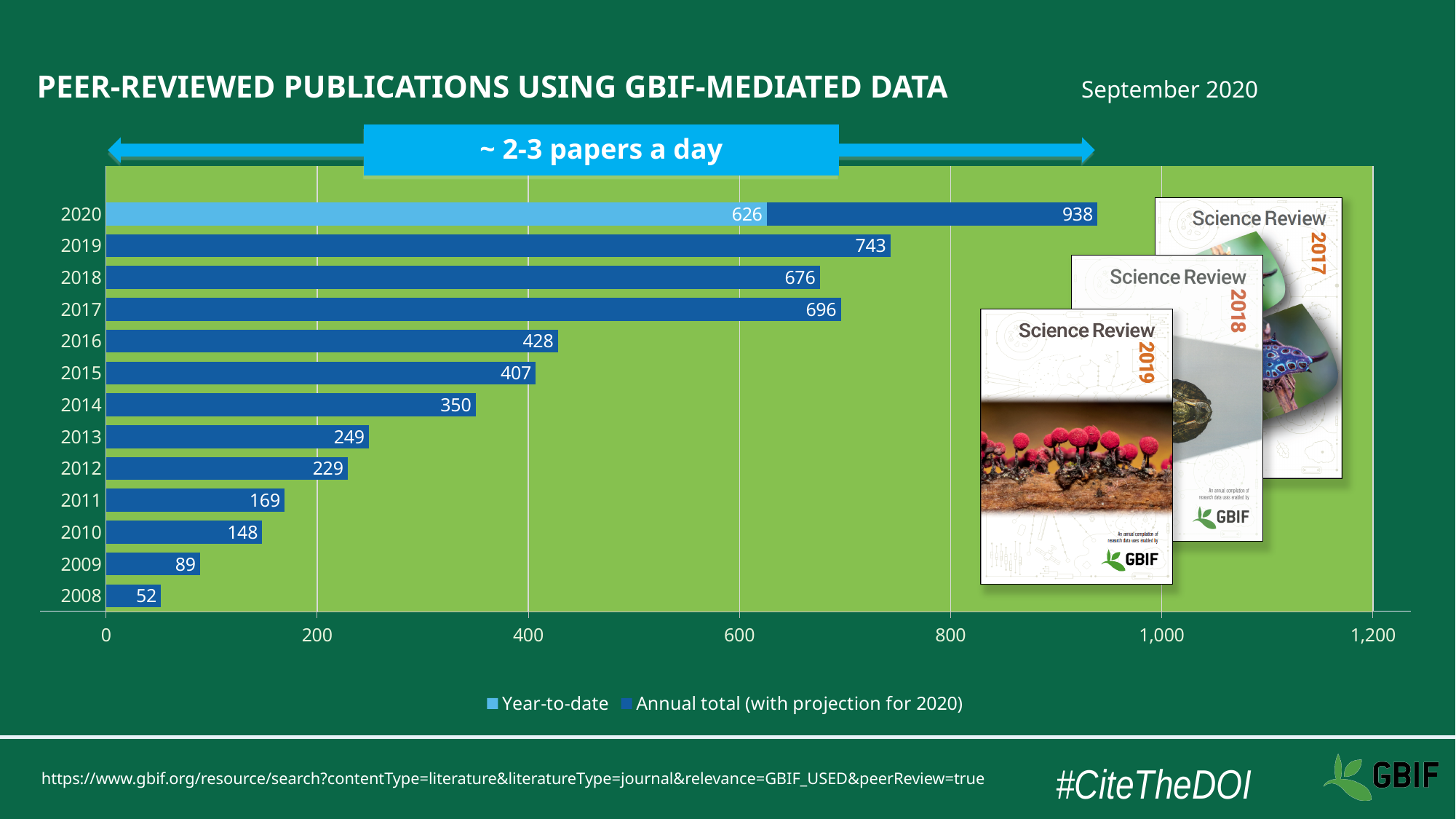
How many series does the legend list? 2 Which year has the lowest value on the chart? 2008 Which year has the highest annual total on the chart? 2020 What is the annual total value shown for 2019? 743 What is the annual total (with projection) value shown for 2020? 938 What kind of chart is shown on the slide? bar chart What is the year-to-date value shown for 2020? 626 What is the value shown for 2008? 52 How many years are shown on the chart? 13 What is the difference between the values for 2019 and 2018? 67 Which year has a larger value, 2017 or 2018? 2017 Is the value for 2016 greater or less than 400? greater